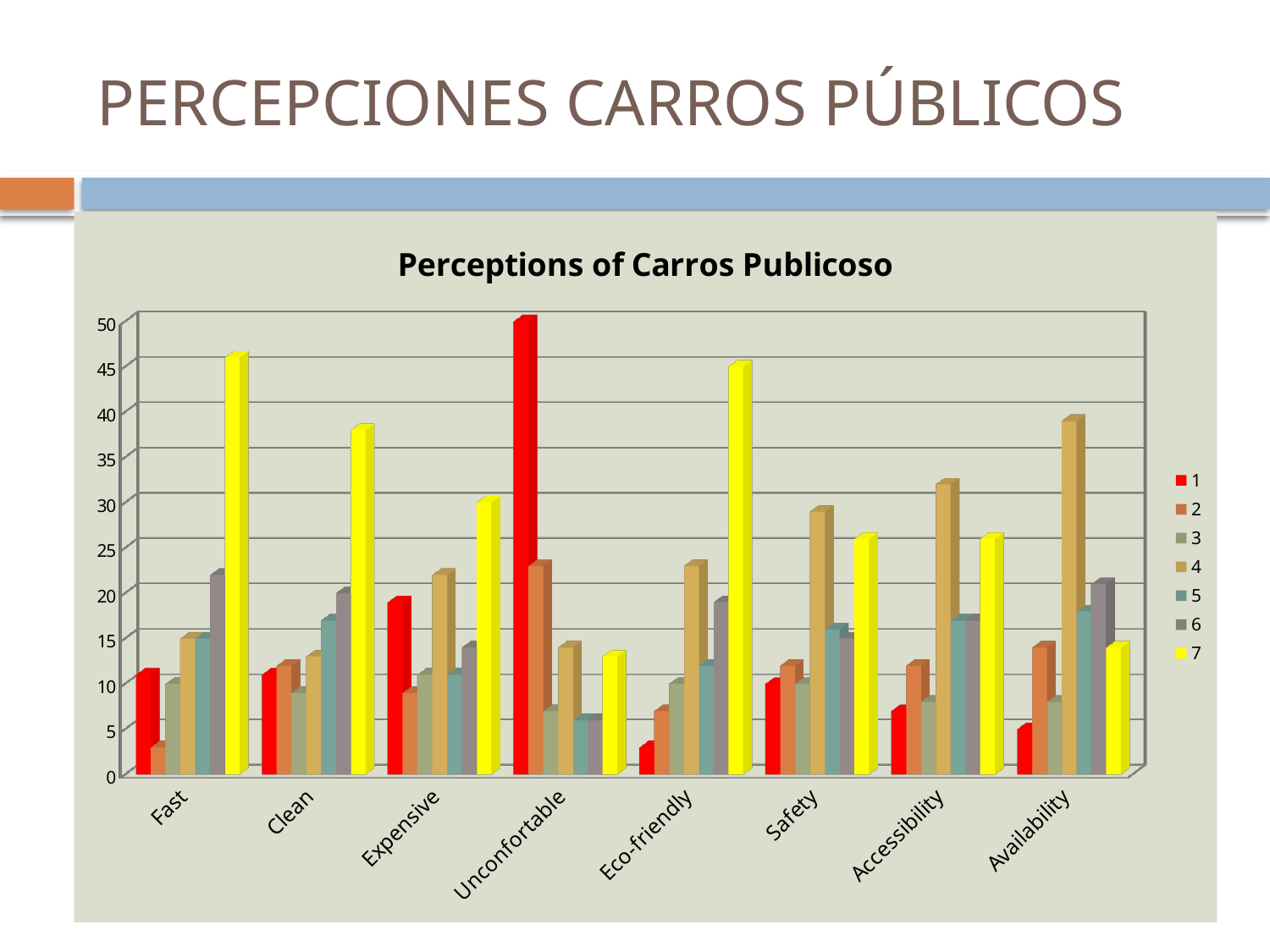
Is the value of series 1 for Eco-friendly greater or less than 5? less What kind of chart is shown on the slide? bar chart How many categories are shown along the x axis of the chart? 8 Is the value of series 7 for Fast greater or less than 40? greater How many series does the chart's legend list? 7 Is the value of series 7 for Unconfortable greater or less than 15? less Which category has the tallest bar for series 1? Unconfortable What is the title of the chart? Perceptions of Carros Publicoso For the Unconfortable category, which is larger: the bar for series 1 or the bar for series 7? series 1 For series 7, which category has the larger bar: Clean or Safety? Clean Which category has the tallest bar for series 4? Availability